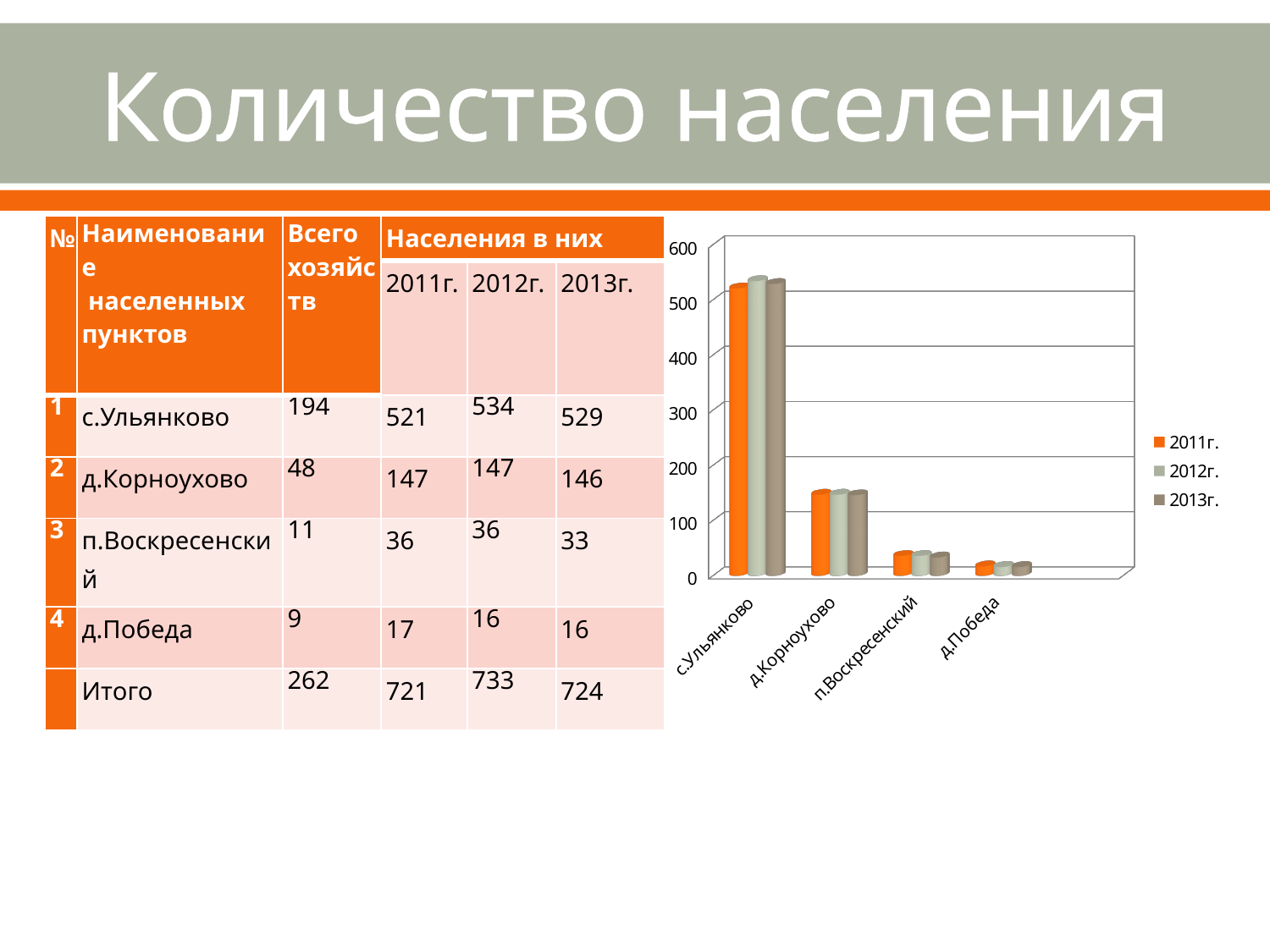
According to the slide, what is the population of с.Ульянково in 2012г.? 534 Which is larger: the 2012г. value for д.Корноухово or the 2012г. value for п.Воскресенский? д.Корноухово How many series does the chart legend list? 3 What kind of chart is shown on the slide? bar chart Is the 2012г. value for п.Воскресенский greater or less than 100? less What are the three legend entries of the chart? 2011г., 2012г., 2013г. Which settlement has the lowest population in the chart? д.Победа Is the 2011г. value for с.Ульянково greater or less than 500? greater According to the slide, what is the population of д.Победа in 2011г.? 17 Is the 2013г. value for д.Корноухово greater or less than 200? less Which settlement has the highest population in the chart? с.Ульянково How many settlements (categories) are shown on the chart's x axis? 4